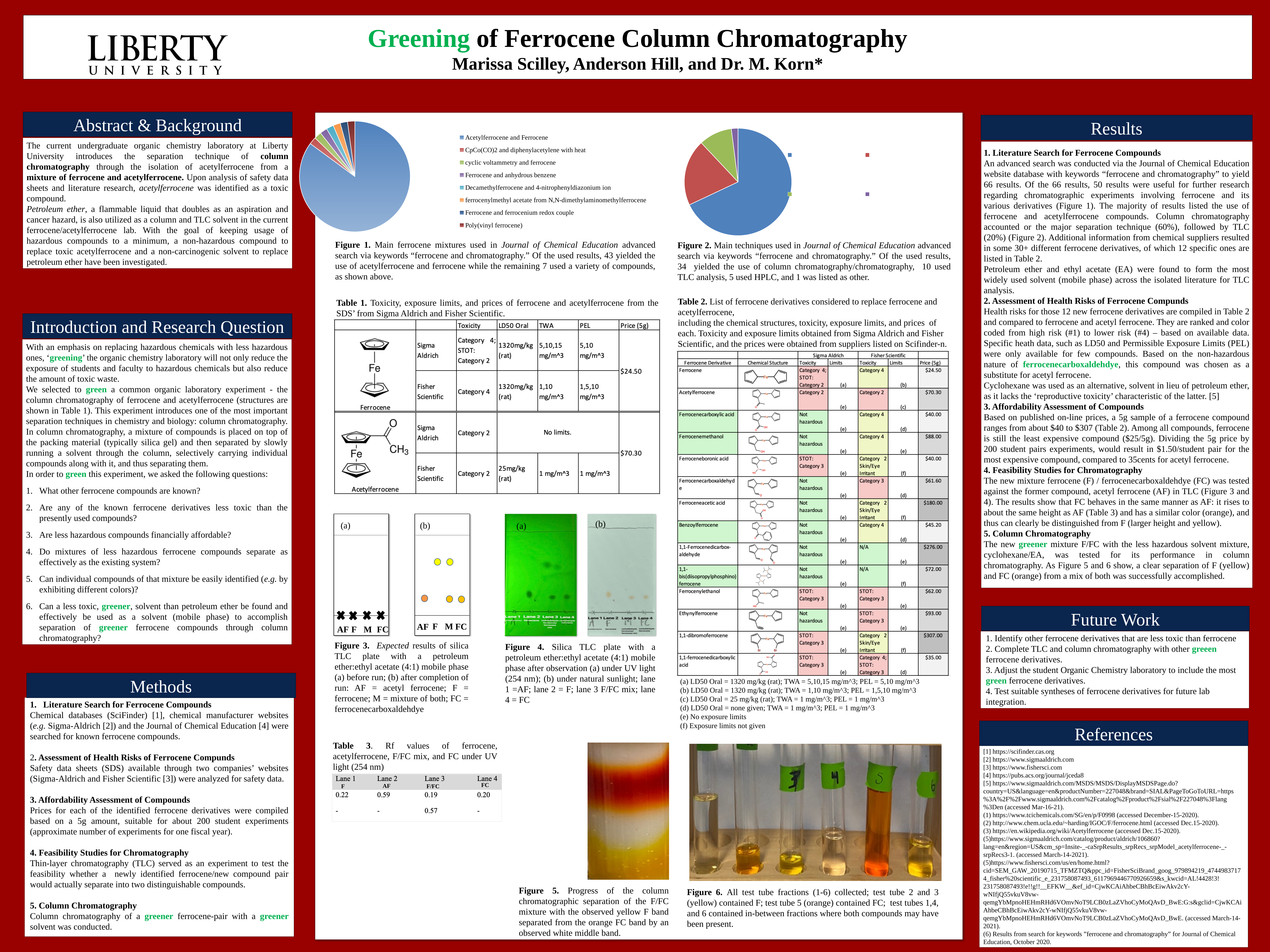
In Figure 1, which slice is larger: Acetylferrocene and Ferrocene or Poly(vinyl ferrocene)? Acetylferrocene and Ferrocene In Figure 2, which slice is larger: the red slice or the green slice? red What kind of chart is Figure 2 (the chart on the right of the centre column)? pie chart What kind of chart is Figure 1 (the chart on the left of the centre column)? pie chart How many categories are plotted in Figure 1? 8 In Figure 2, does the blue slice take up more or less than half of the pie? more How many slices does the pie in Figure 2 have? 4 In Figure 2, what colour is the largest slice? blue In Figure 1, what colour is the Acetylferrocene and Ferrocene slice? blue In Figure 1, does the Acetylferrocene and Ferrocene slice take up more or less than half of the pie? more In Figure 1, which category has the largest slice? Acetylferrocene and Ferrocene How many entries does the legend of Figure 1 list? 8